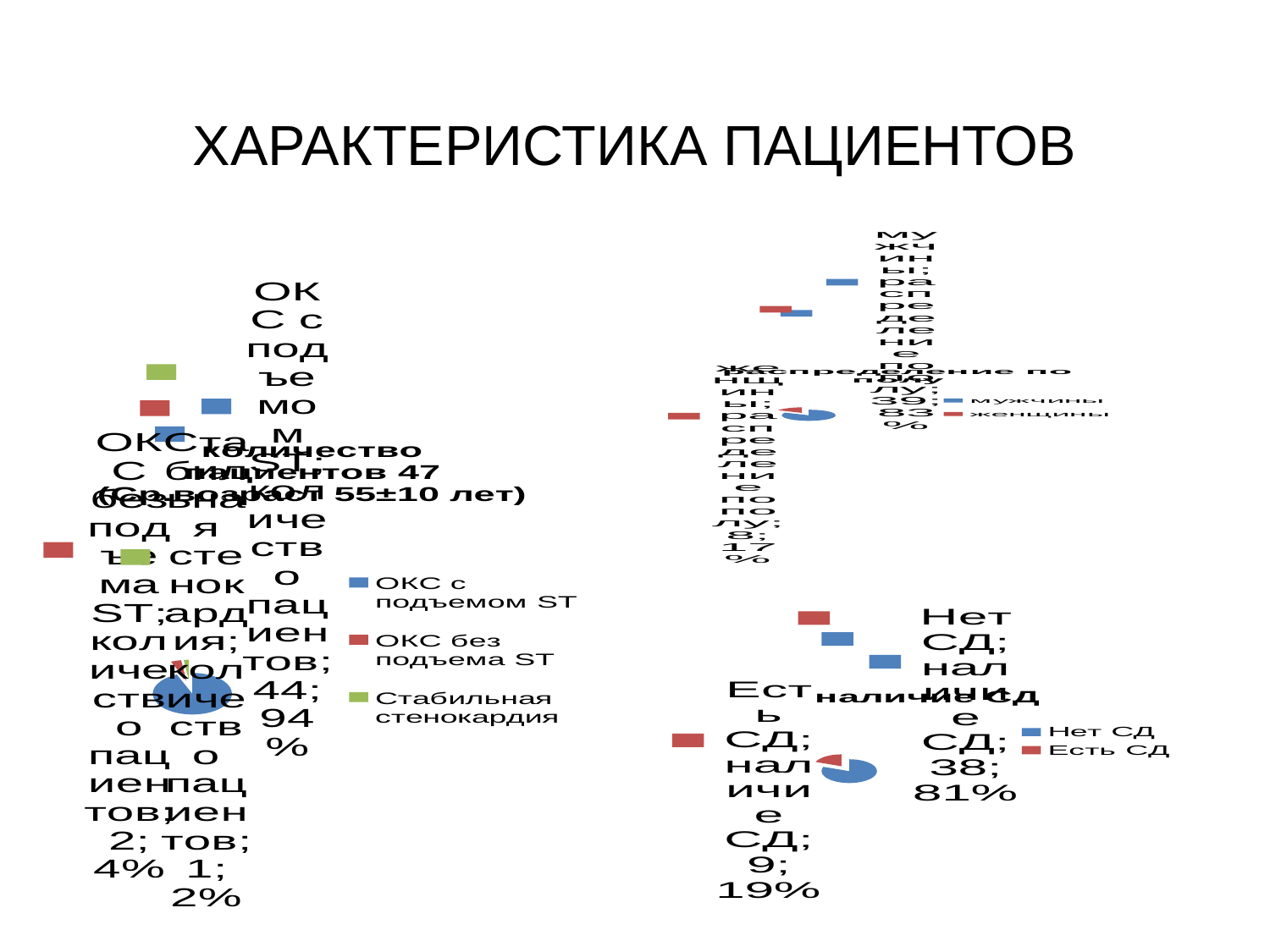
In the chart titled "распределение по полу", what is the difference between the number of "мужчины" and "женщины"? 31 In the chart titled "количество пациентов 47", how many categories does the legend list? 3 In the chart titled "количество пациентов 47", which category has the smallest number of patients? Стабильная стенокардия What kind of chart is the chart titled "количество пациентов 47"? pie chart How many pie charts are shown on the slide? 3 In the chart titled "наличие СД", which category is larger, "Нет СД" or "Есть СД"? Нет СД In the chart titled "наличие СД", how many patients are in the "Есть СД" category? 9 In the chart titled "распределение по полу", what percentage share do "женщины" have? 17% In the chart titled "распределение по полу", how many patients are "мужчины"? 39 In the chart titled "количество пациентов 47", what percentage share does "ОКС без подъема ST" have? 4% In the chart titled "наличие СД", what percentage share does "Нет СД" have? 81% In the chart titled "количество пациентов 47", how many patients are in the "ОКС с подъемом ST" category? 44